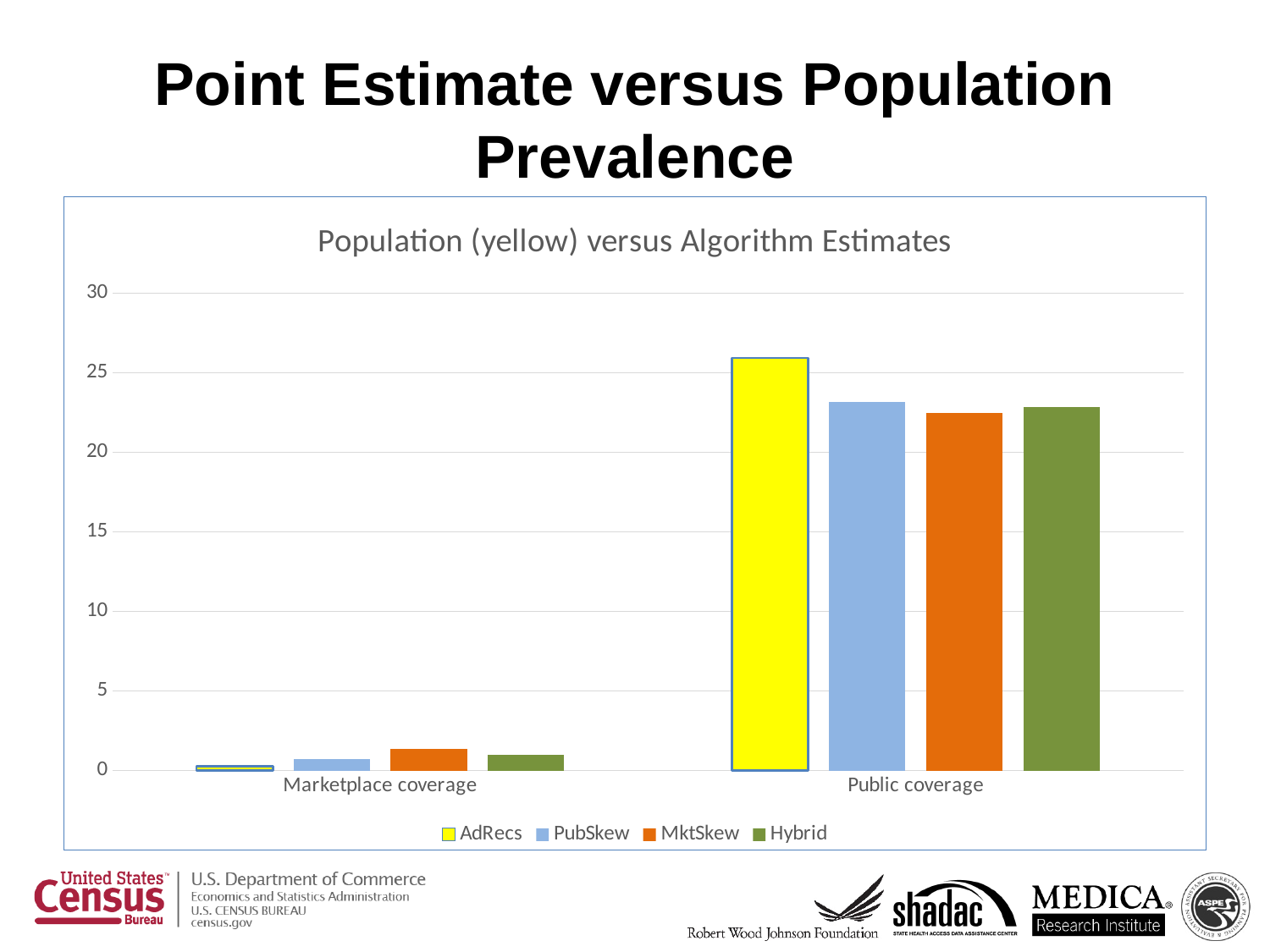
How many categories are shown on the x axis? 2 How many series does the legend list? 4 Which series has the highest value for Public coverage? AdRecs What is the title of the chart? Population (yellow) versus Algorithm Estimates Which series has the lowest value for Marketplace coverage? AdRecs Which series is shown in yellow in the legend? AdRecs Which series has the highest value for Marketplace coverage? MktSkew What kind of chart is shown on the slide? bar chart Is the MktSkew value for Marketplace coverage greater or less than 5? less Is the AdRecs value for Public coverage greater or less than 25? greater For Public coverage, which is larger, the AdRecs value or the PubSkew value? AdRecs Is the PubSkew value for Public coverage greater or less than 25? less